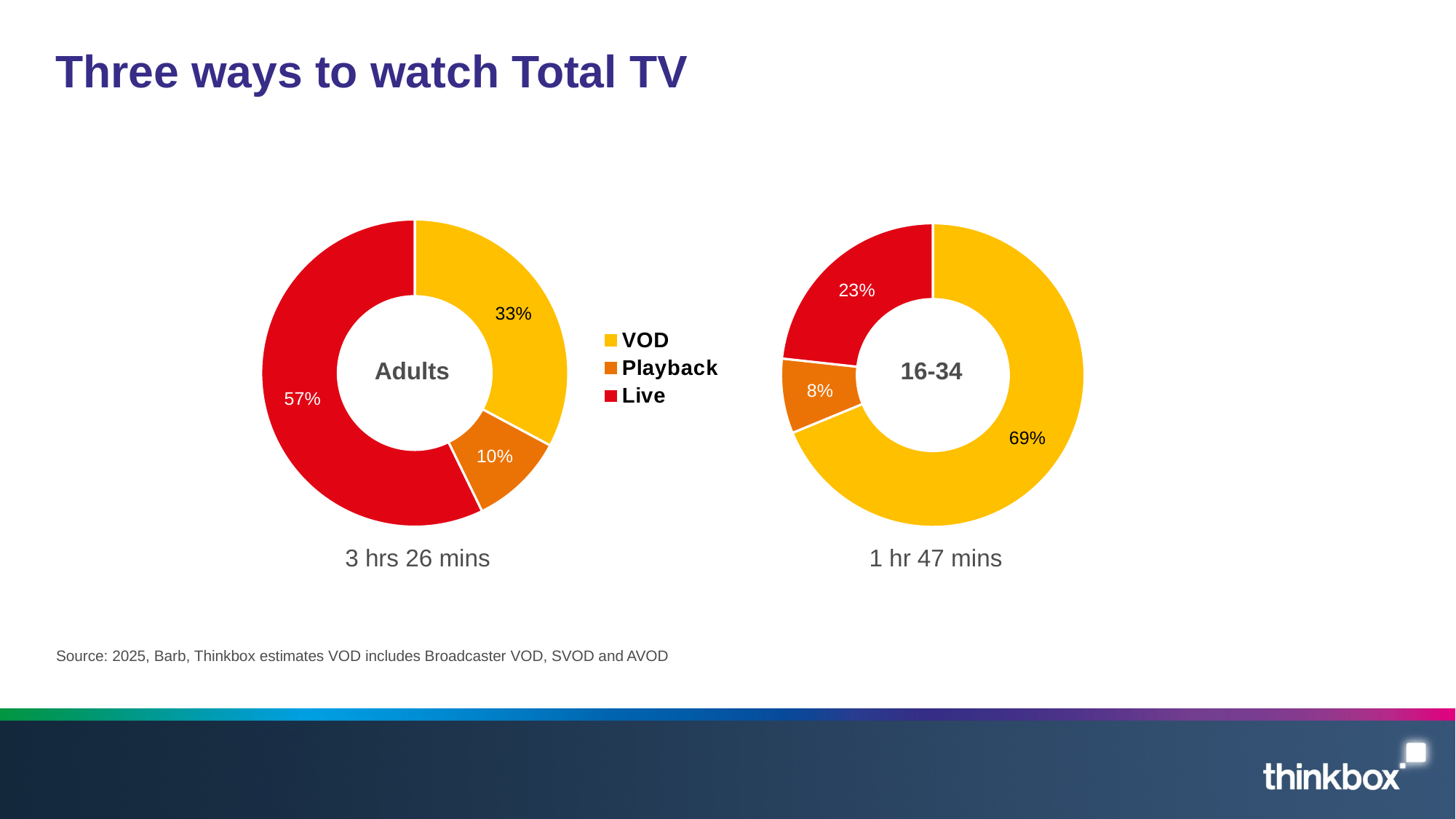
What total viewing time is shown beneath the 16-34 chart? 1 hr 47 mins In the Adults chart, what share of viewing is Live? 57% Is the VOD share larger in the Adults chart or the 16-34 chart? 16-34 In the 16-34 chart, what is the difference between the VOD share and the Live share? 46 percentage points In the 16-34 chart, which category has the smallest share? Playback In the 16-34 chart, what share of viewing is Live? 23% In the Adults chart, what share of viewing is Playback? 10% In the Adults chart, which category has the largest share? Live How many series does the legend list? 3 In the Adults chart, what is the difference between the Live share and the VOD share? 24 percentage points What kind of chart is used on this slide? Doughnut chart In the 16-34 chart, what share of viewing is VOD? 69%